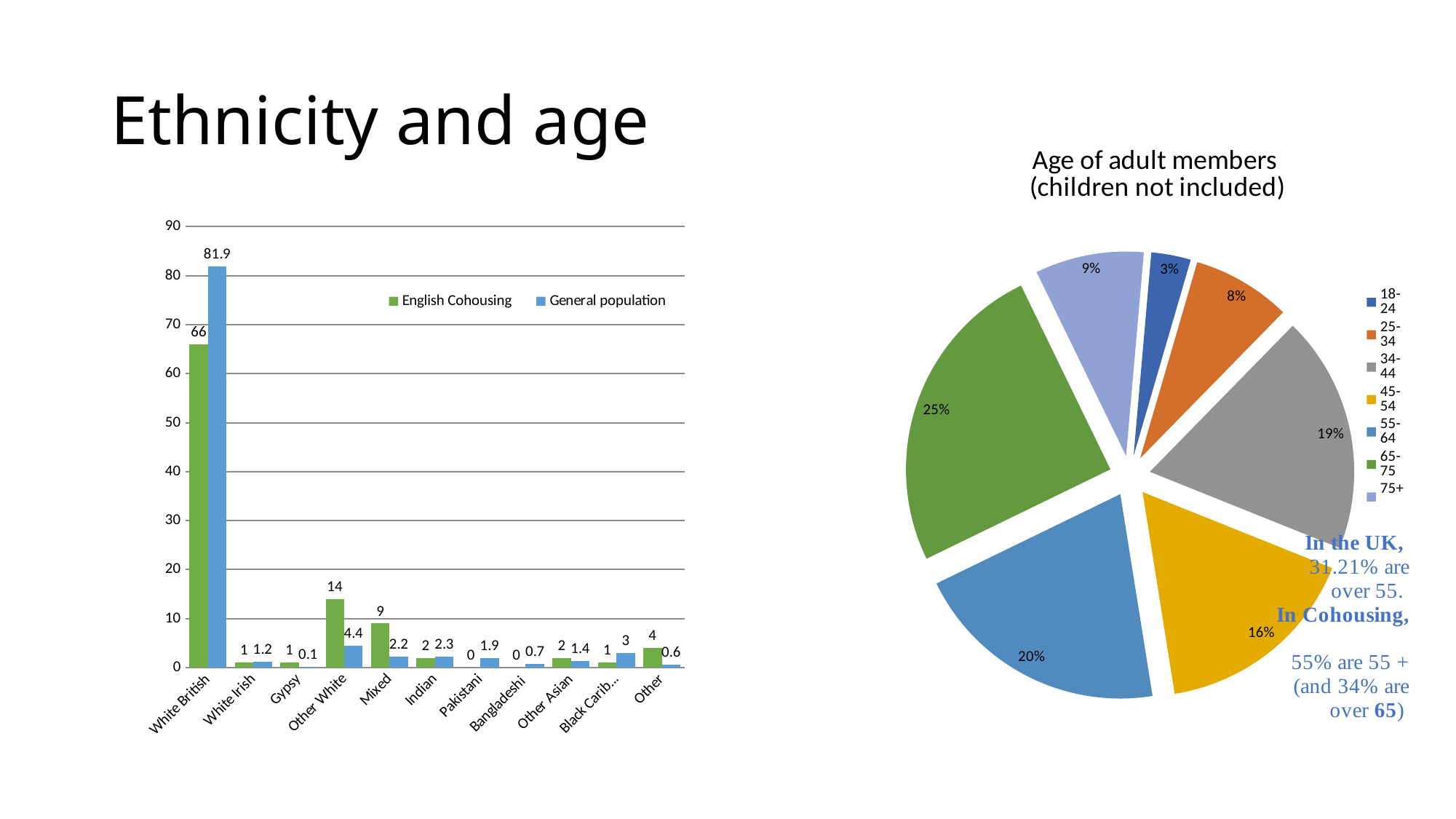
In the 'Age of adult members' pie chart, how many age groups does the legend list? 7 In the 'Age of adult members' pie chart, which age group has the smallest share? 18-24 In the bar chart on the left, what is the General population value for Other White? 4.4 In the bar chart on the left, what is the English Cohousing value for White British? 66 In the 'Age of adult members' pie chart, what share is the 65-75 slice? 25% What kind of chart is the chart on the left of the slide? Bar chart What is the title of the pie chart on the right? Age of adult members (children not included) In the bar chart on the left, what is the difference between the General population and English Cohousing values for White British? 15.9 In the bar chart on the left, how many ethnicity categories are shown on the x axis? 11 In the bar chart on the left, which category has the highest General population value? White British In the bar chart on the left, how many series does the legend list? 2 In the bar chart on the left, which is larger for Mixed: English Cohousing or General population? English Cohousing